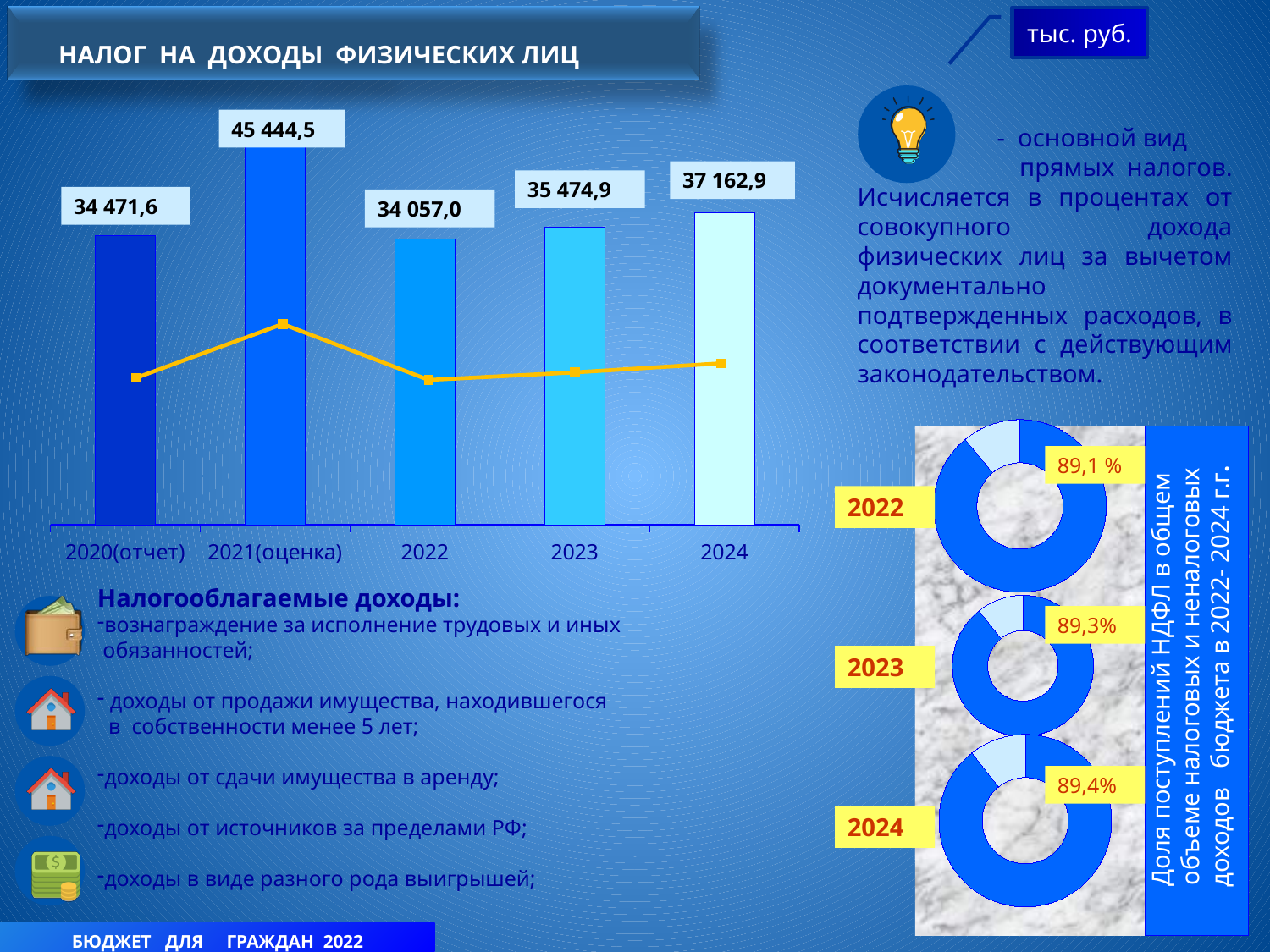
On the donut charts at the bottom right showing the share of НДФЛ in total budget revenues, what is the share for 2023? 89,3% What unit is indicated for the values on the bar chart of personal income tax? тыс. руб. How many years (categories) are shown on the bar chart of personal income tax? 5 On the bar chart of personal income tax, which year has the highest value? 2021(оценка) On the bar chart of personal income tax, what is the value for 2024? 37 162,9 On the bar chart of personal income tax, do the values rise or fall from 2022 to 2024? rise On the bar chart of personal income tax, which is larger: the value for 2020(отчет) or the value for 2022? 2020(отчет) On the bar chart of personal income tax (НАЛОГ НА ДОХОДЫ ФИЗИЧЕСКИХ ЛИЦ), what is the value for 2021(оценка)? 45 444,5 On the bar chart of personal income tax, what is the value for 2020(отчет)? 34 471,6 On the bar chart of personal income tax, which year has the lowest value? 2022 On the bar chart of personal income tax, what is the difference between the 2024 value and the 2023 value? 1 688,0 On the donut charts at the bottom right showing the share of НДФЛ in total budget revenues, what is the share for 2022? 89,1 %